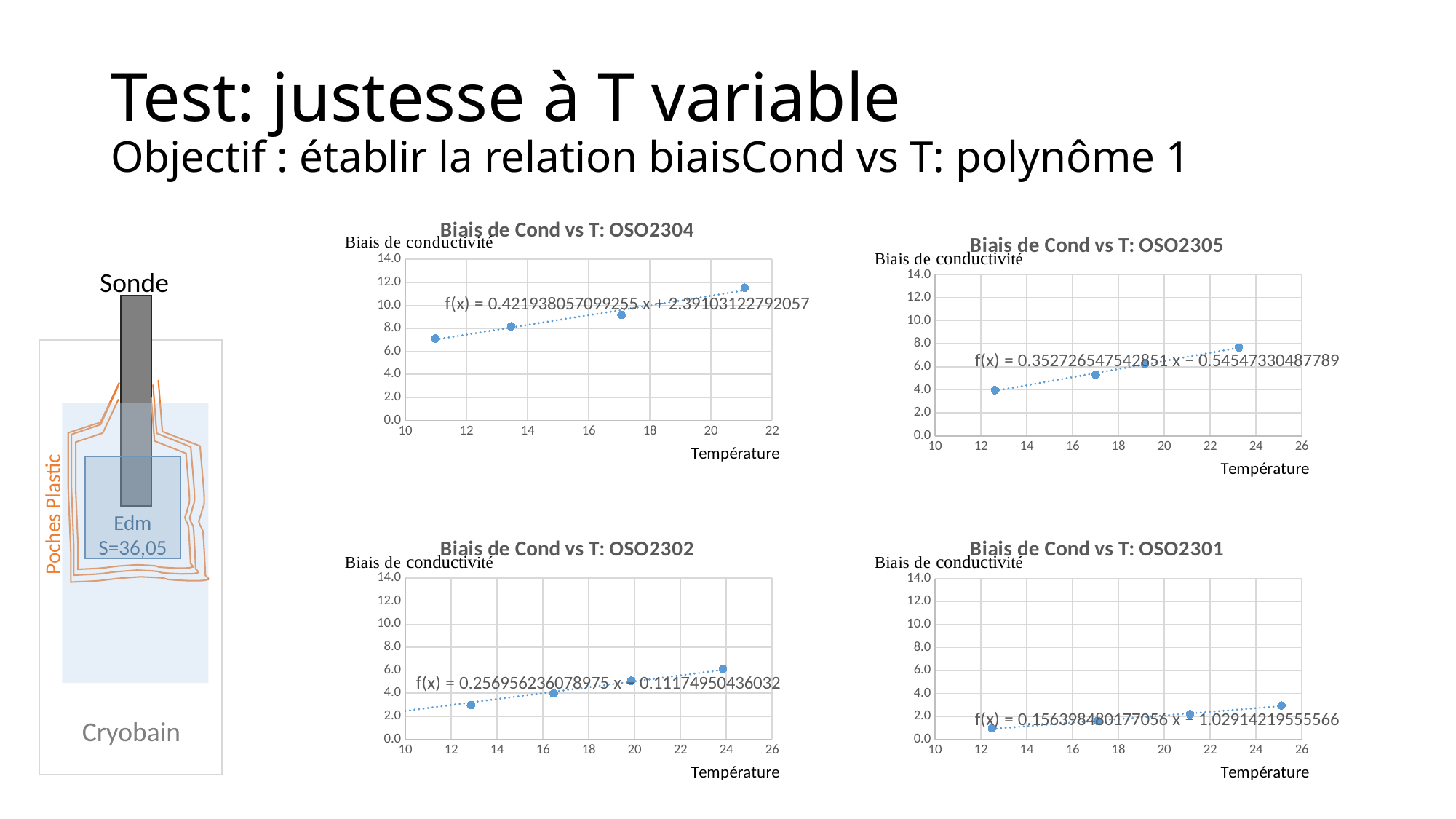
In the chart "Biais de Cond vs T: OSO2301", do the values rise or fall along the x axis? rise How many data points are plotted in the chart "Biais de Cond vs T: OSO2301"? 4 In the chart "Biais de Cond vs T: OSO2301", is the highest plotted value greater or less than 4.0? less In the chart "Biais de Cond vs T: OSO2304", is the highest plotted value greater or less than 10.0? greater What is the trendline equation shown in the chart "Biais de Cond vs T: OSO2304"? f(x) = 0.421938057099255 x + 2.39103122792057 In the chart "Biais de Cond vs T: OSO2302", do the values rise or fall as temperature increases? rise In the chart "Biais de Cond vs T: OSO2304", is the lowest plotted value greater or less than 6.0? greater How many data points are plotted in the chart "Biais de Cond vs T: OSO2305"? 4 How many charts are shown on the slide? 4 What kind of chart is "Biais de Cond vs T: OSO2304"? scatter chart What is the x-axis label of the chart "Biais de Cond vs T: OSO2302"? Température